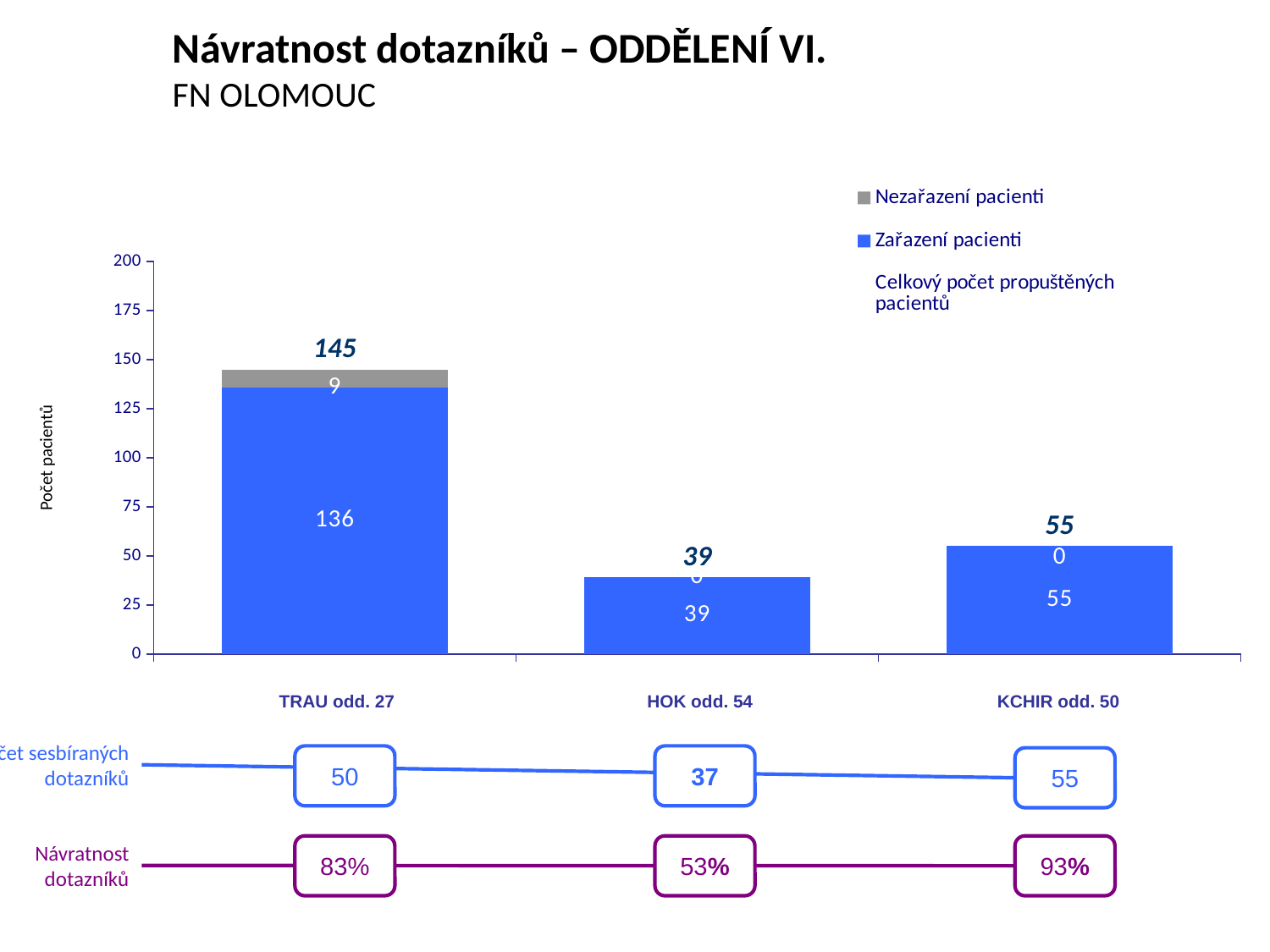
How many departments are shown on the x axis of the chart? 3 How many Zařazení pacienti are shown for KCHIR odd. 50? 55 Which department has the lowest total number of patients? HOK odd. 54 What is the label of the y axis of the chart? Počet pacientů What type of chart is shown on the slide? Stacked bar chart What is the total number of patients shown above the HOK odd. 54 bar? 39 Which has more Zařazení pacienti, HOK odd. 54 or KCHIR odd. 50? KCHIR odd. 50 How many Zařazení pacienti are shown for TRAU odd. 27? 136 How many Nezařazení pacienti are shown for TRAU odd. 27? 9 Which department has the highest total number of patients? TRAU odd. 27 What is the difference between the total patients for TRAU odd. 27 and KCHIR odd. 50? 90 What is the total number of patients shown above the TRAU odd. 27 bar? 145